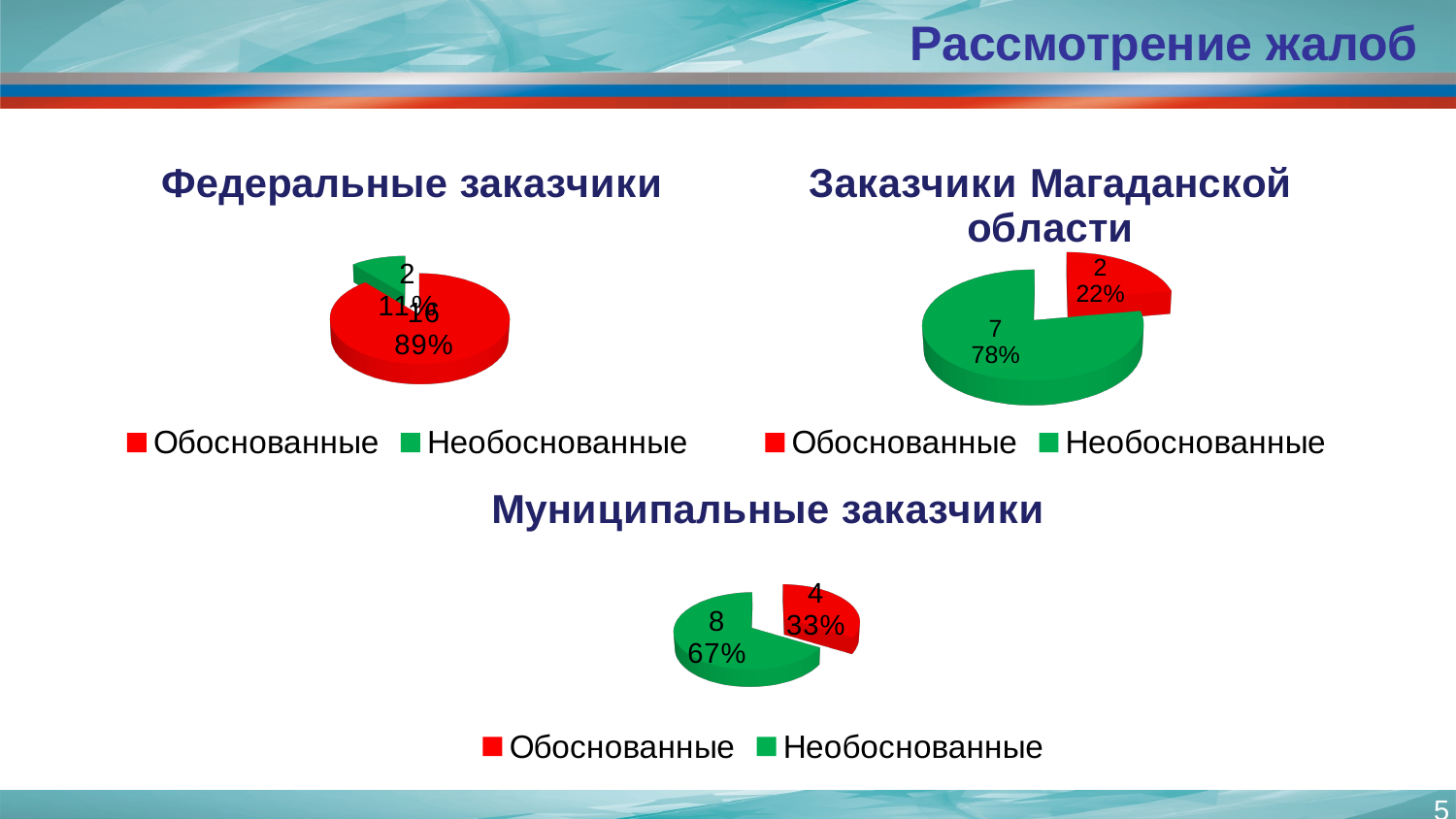
In the "Федеральные заказчики" chart, what share of complaints is "Обоснованные"? 89% In the "Федеральные заказчики" chart, which colour represents "Обоснованные"? red In the "Заказчики Магаданской области" chart, what share of complaints is "Обоснованные"? 22% In the "Муниципальные заказчики" chart, what share of complaints is "Необоснованные"? 67% In the "Муниципальные заказчики" chart, how many complaints are "Обоснованные"? 4 How many categories does the legend of the "Муниципальные заказчики" chart list? 2 In the "Федеральные заказчики" chart, how many complaints are "Необоснованные"? 2 In the "Муниципальные заказчики" chart, what is the total number of complaints across both categories? 12 In the "Заказчики Магаданской области" chart, which category is larger, "Обоснованные" or "Необоснованные"? Необоснованные In the "Муниципальные заказчики" chart, what is the difference between the number of "Необоснованные" and "Обоснованные" complaints? 4 What kind of chart is used for "Федеральные заказчики"? pie chart In the "Заказчики Магаданской области" chart, how many complaints are "Необоснованные"? 7